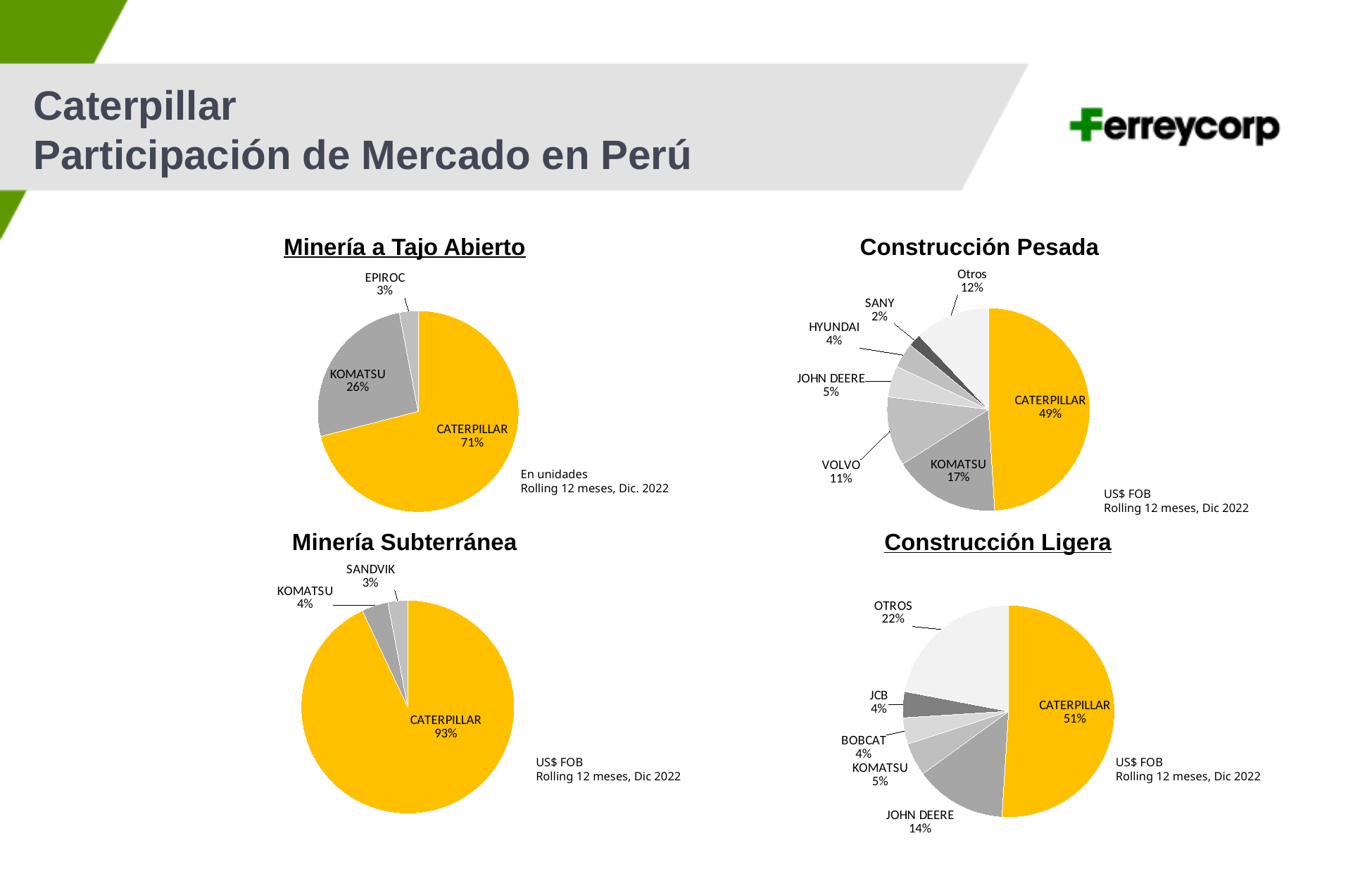
What type of chart is used for the four charts on this slide? Pie chart In the Construcción Ligera chart, what share does JOHN DEERE hold? 14% In the Minería a Tajo Abierto chart, what share does CATERPILLAR hold? 71% In the Construcción Pesada chart, which is larger, the VOLVO share or the JOHN DEERE share? VOLVO In the Construcción Ligera chart, what is the difference between the CATERPILLAR and OTROS shares? 29% In the Construcción Pesada chart, how many slices does the pie have? 7 In the Minería a Tajo Abierto chart, what is the difference between the CATERPILLAR and KOMATSU shares? 45% In the Construcción Pesada chart, what share does KOMATSU hold? 17% In the Minería a Tajo Abierto chart, which brand has the smallest share? EPIROC In the Construcción Pesada chart, which brand has the smallest share? SANY In the Minería Subterránea chart, what is the combined share of KOMATSU and SANDVIK? 7% In the Minería Subterránea chart, what share does CATERPILLAR hold? 93%